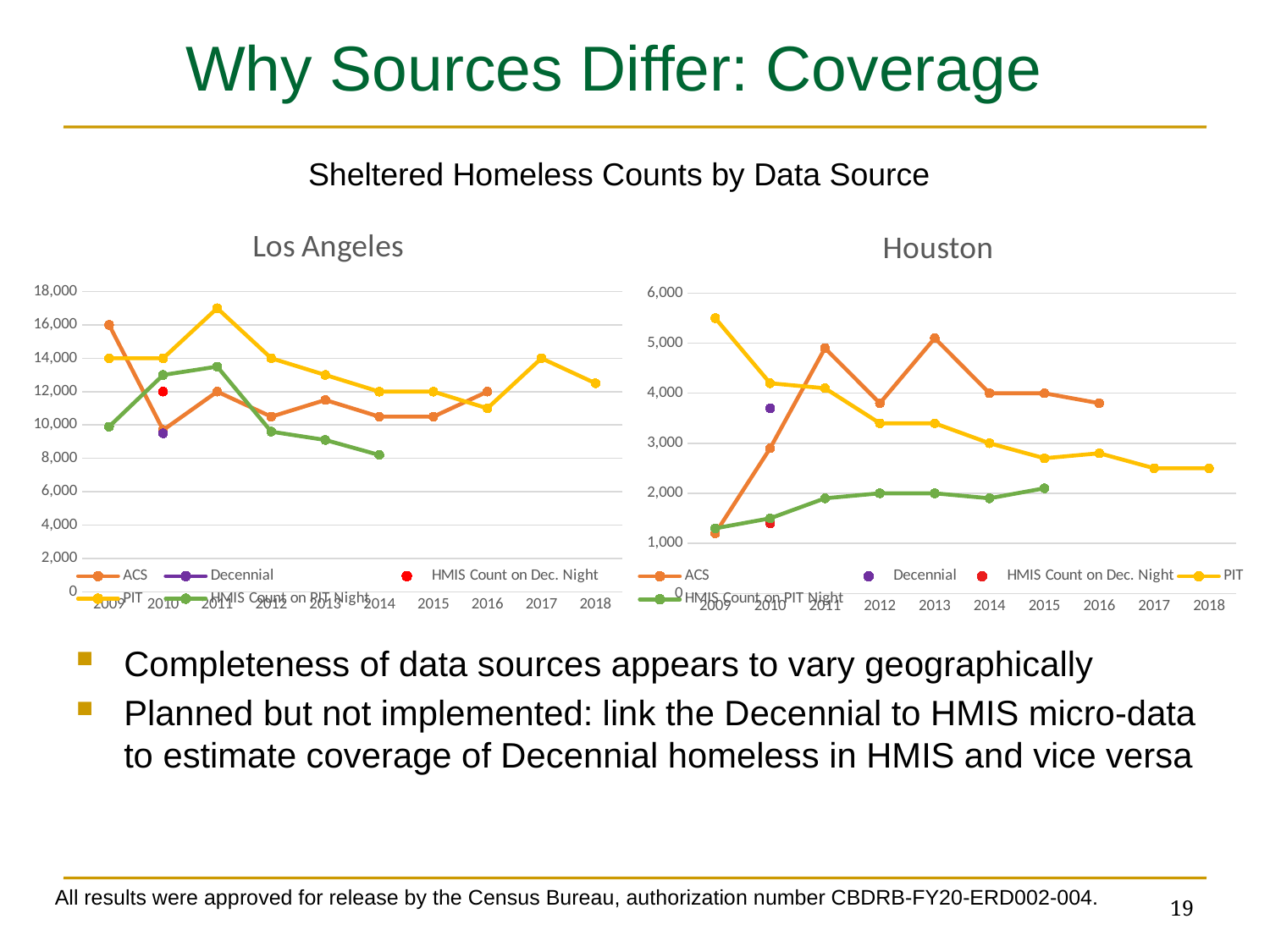
In the Houston chart, which is larger in 2010: the Decennial value or the HMIS Count on Dec. Night value? Decennial What kind of chart is the Los Angeles chart? line chart How many series does the legend of the Houston chart list? 5 In the Houston chart, is the PIT value for 2009 greater or less than 5,000? greater In the Houston chart, is the ACS value for 2009 greater or less than 2,000? less In the Los Angeles chart, which is larger in 2010: the Decennial value or the HMIS Count on Dec. Night value? HMIS Count on Dec. Night In the Houston chart, does the PIT series generally rise or fall from 2009 to 2018? fall In the Los Angeles chart, is the PIT value for 2011 greater or less than 16,000? greater How many years are shown on the x axis of the Los Angeles chart? 10 In the Los Angeles chart, in which year is the PIT series at its highest? 2011 In the Houston chart, in which year is the PIT series at its highest? 2009